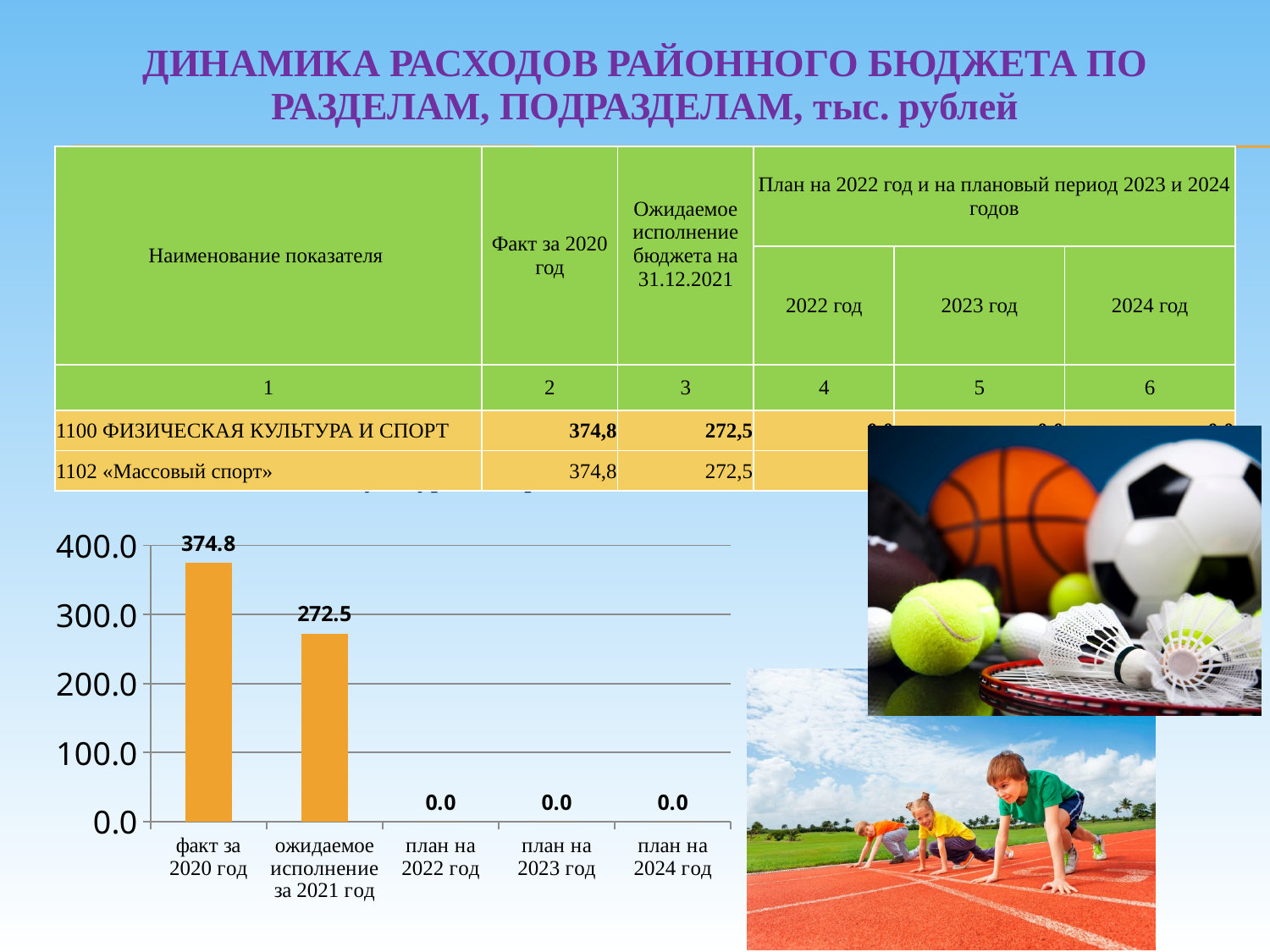
Do the values in the bar chart rise or fall from "факт за 2020 год" to "план на 2022 год"? fall What is the value for "ожидаемое исполнение за 2021 год" in the bar chart? 272.5 Which is larger in the bar chart: the value for "факт за 2020 год" or for "ожидаемое исполнение за 2021 год"? факт за 2020 год What is the value for "план на 2024 год" in the bar chart? 0.0 What kind of chart is shown on the slide? bar chart What is the value for "факт за 2020 год" in the bar chart? 374.8 Is the value for "факт за 2020 год" greater or less than 300.0? greater Which category has the highest value in the bar chart? факт за 2020 год How many categories are shown on the x axis of the bar chart? 5 Is the value for "ожидаемое исполнение за 2021 год" greater or less than 300.0? less What is the difference between the values for "факт за 2020 год" and "ожидаемое исполнение за 2021 год" in the bar chart? 102.3 What is the value for "план на 2022 год" in the bar chart? 0.0